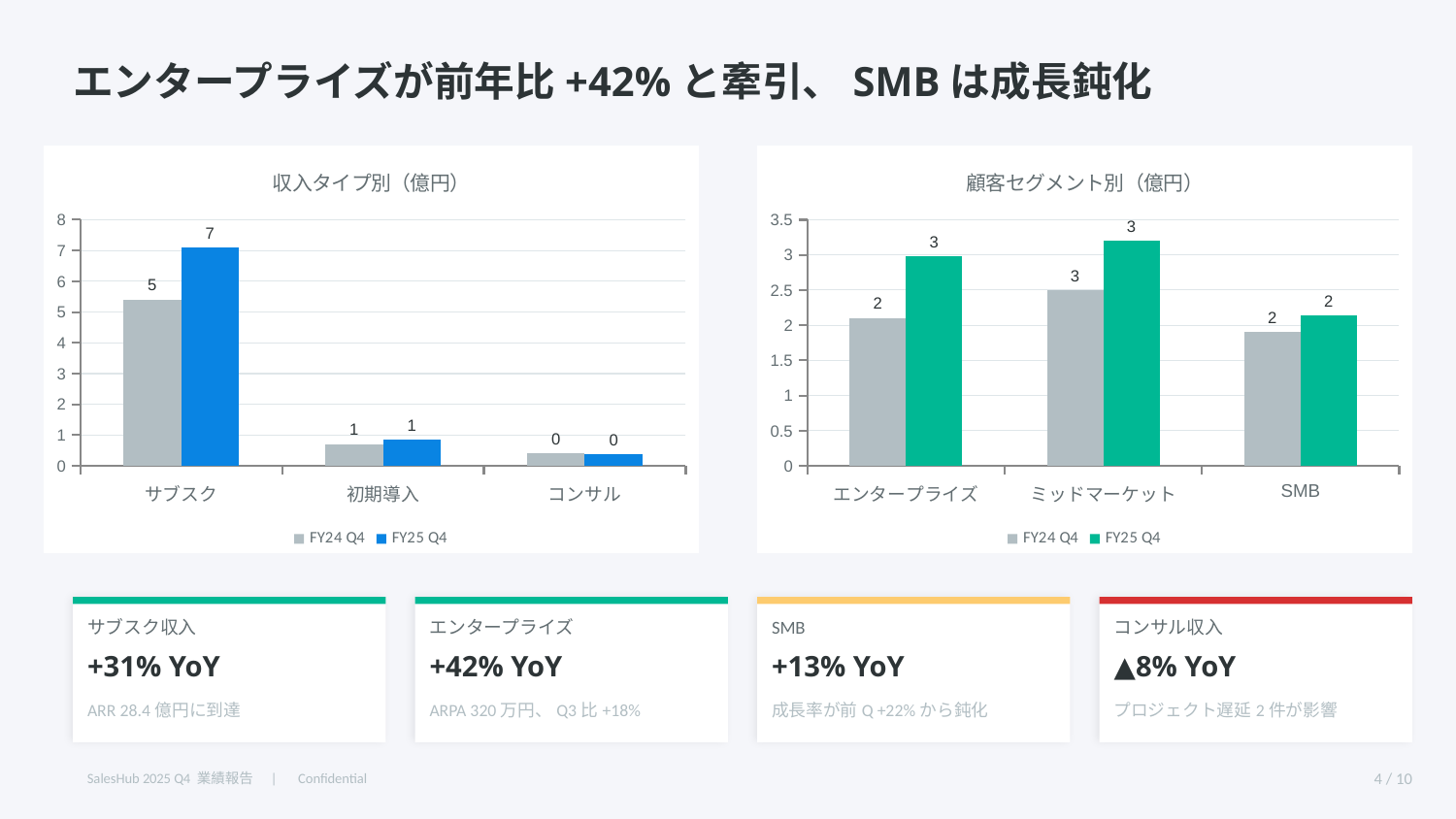
In the chart titled 収入タイプ別（億円）, what is the FY24 Q4 value for サブスク? 5 In the chart titled 収入タイプ別（億円）, which is larger: the FY25 Q4 value for 初期導入 or the FY25 Q4 value for コンサル? 初期導入 In the chart titled 収入タイプ別（億円）, what is the difference between the FY25 Q4 and FY24 Q4 data labels for サブスク? 2 In the chart titled 収入タイプ別（億円）, what is the FY25 Q4 value for サブスク? 7 In the chart titled 顧客セグメント別（億円）, which category has the highest FY24 Q4 value? ミッドマーケット What kind of chart is the chart titled 顧客セグメント別（億円）? bar chart In the chart titled 顧客セグメント別（億円）, what is the FY25 Q4 value for エンタープライズ? 3 How many categories are shown on the x axis of the chart titled 顧客セグメント別（億円）? 3 In the chart titled 収入タイプ別（億円）, which category has the lowest FY25 Q4 value? コンサル In the chart titled 収入タイプ別（億円）, which category has the highest FY25 Q4 value? サブスク In the chart titled 顧客セグメント別（億円）, is the FY25 Q4 value for エンタープライズ greater or less than 2.5? greater How many series does the legend of the chart titled 収入タイプ別（億円）list? 2